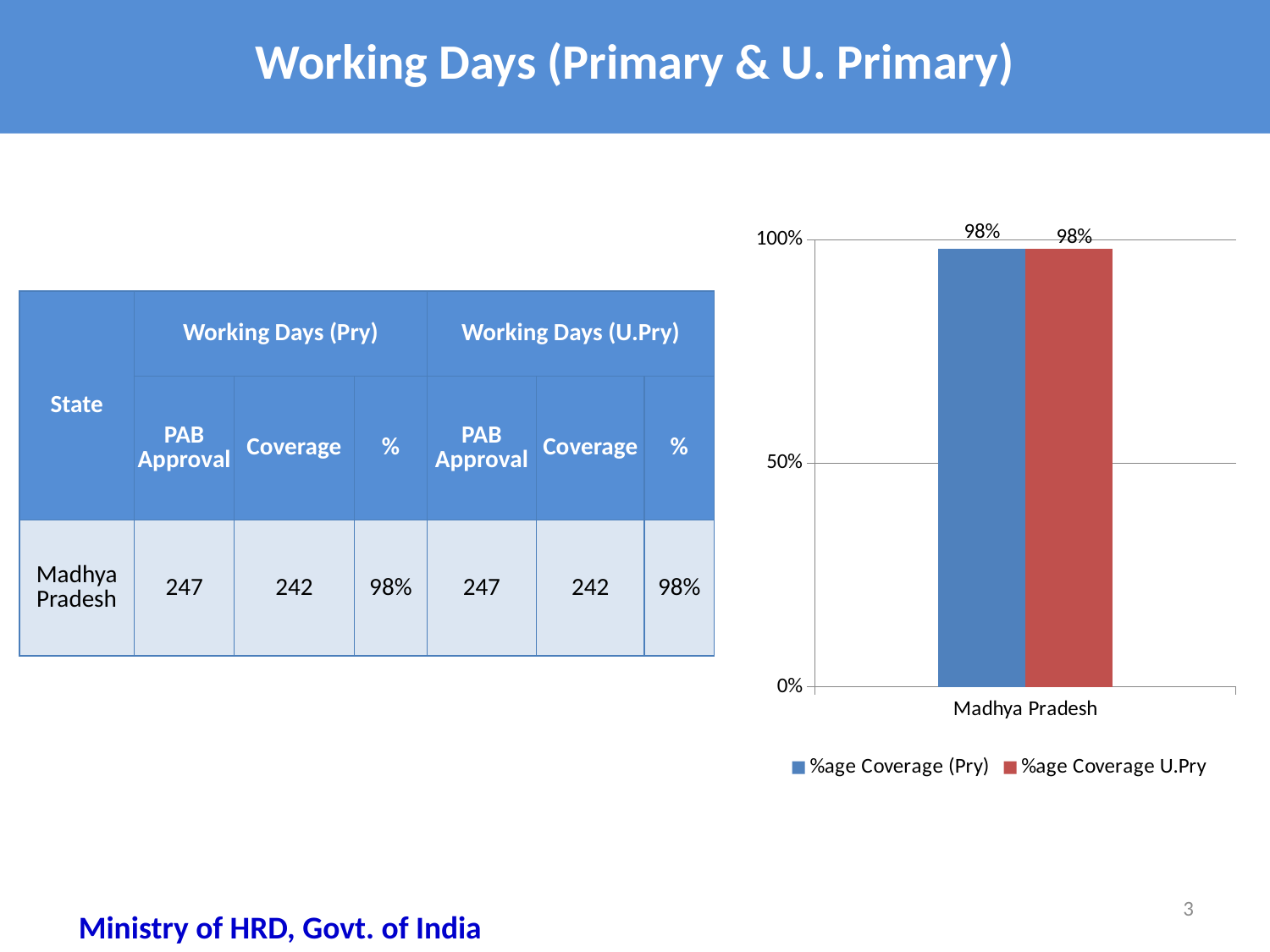
How many categories are shown on the x axis of the chart? 1 Is the %age Coverage (Pry) value for Madhya Pradesh greater or less than 50%? greater What kind of chart is shown on the slide? bar chart How many series does the chart legend list? 2 What is the %age Coverage U.Pry value for Madhya Pradesh in the chart? 98% What is the difference between the %age Coverage (Pry) and %age Coverage U.Pry values for Madhya Pradesh? 0% Is the %age Coverage U.Pry value for Madhya Pradesh greater or less than 50%? greater What is the %age Coverage (Pry) value for Madhya Pradesh in the chart? 98% Which series in the chart is shown in red? %age Coverage U.Pry Which category is shown on the x axis of the chart? Madhya Pradesh